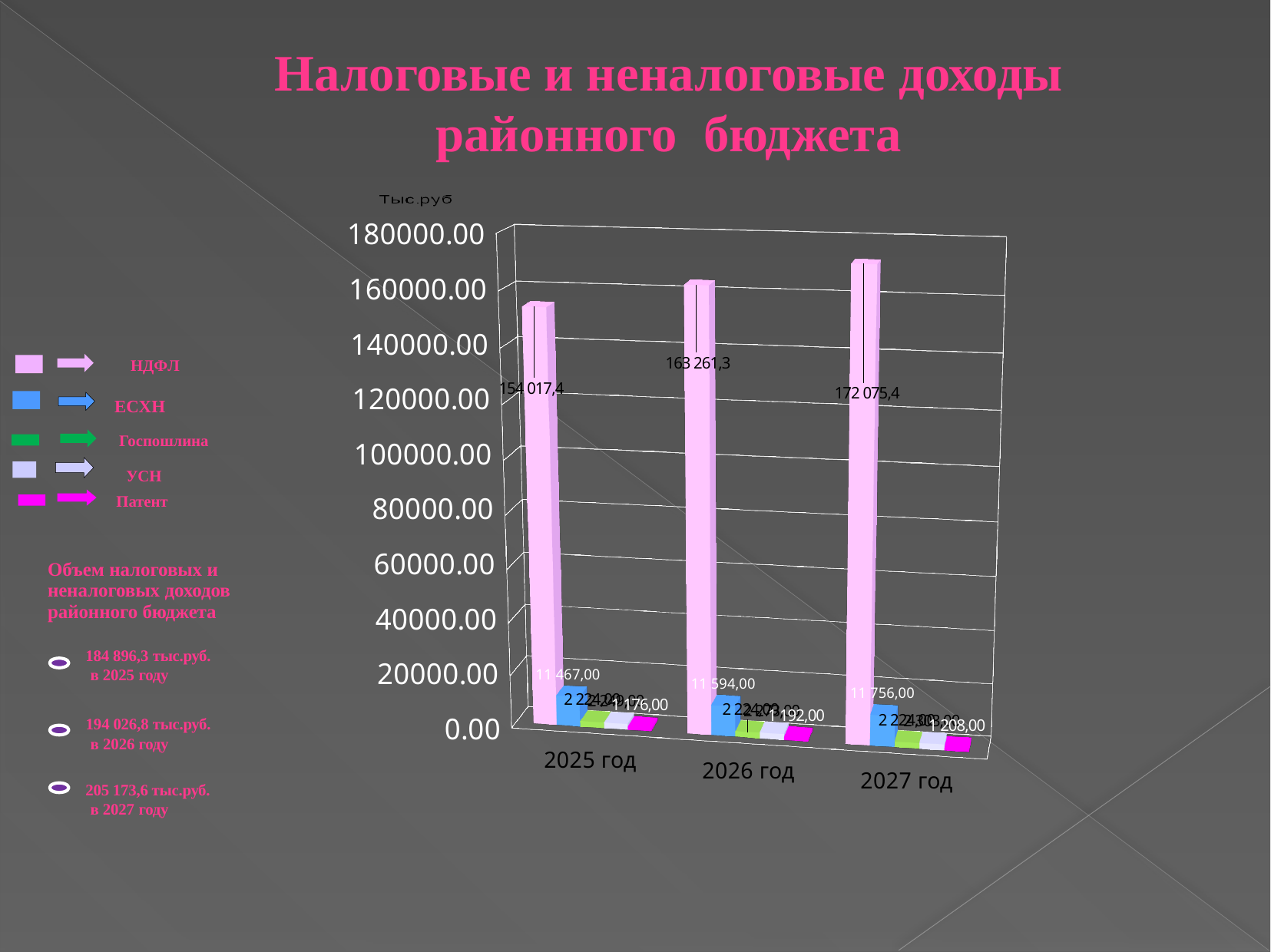
How many series does the legend list? 5 What kind of chart is shown on the slide? bar chart What is the difference between the НДФЛ values for 2027 год and 2026 год? 8 814,1 What is the value of НДФЛ for 2025 год? 154 017,4 Do the НДФЛ values rise or fall from 2025 год to 2027 год? rise Which is larger for 2025 год: ЕСХН or Патент? ЕСХН What is the value of НДФЛ for 2027 год? 172 075,4 What is the value of ЕСХН for 2026 год? 11 594,00 How many year categories are shown on the x axis? 3 In which year is the НДФЛ value the highest? 2027 год What is the value of Патент for 2027 год? 1 208,00 What is the difference between the ЕСХН values for 2027 год and 2025 год? 289,00